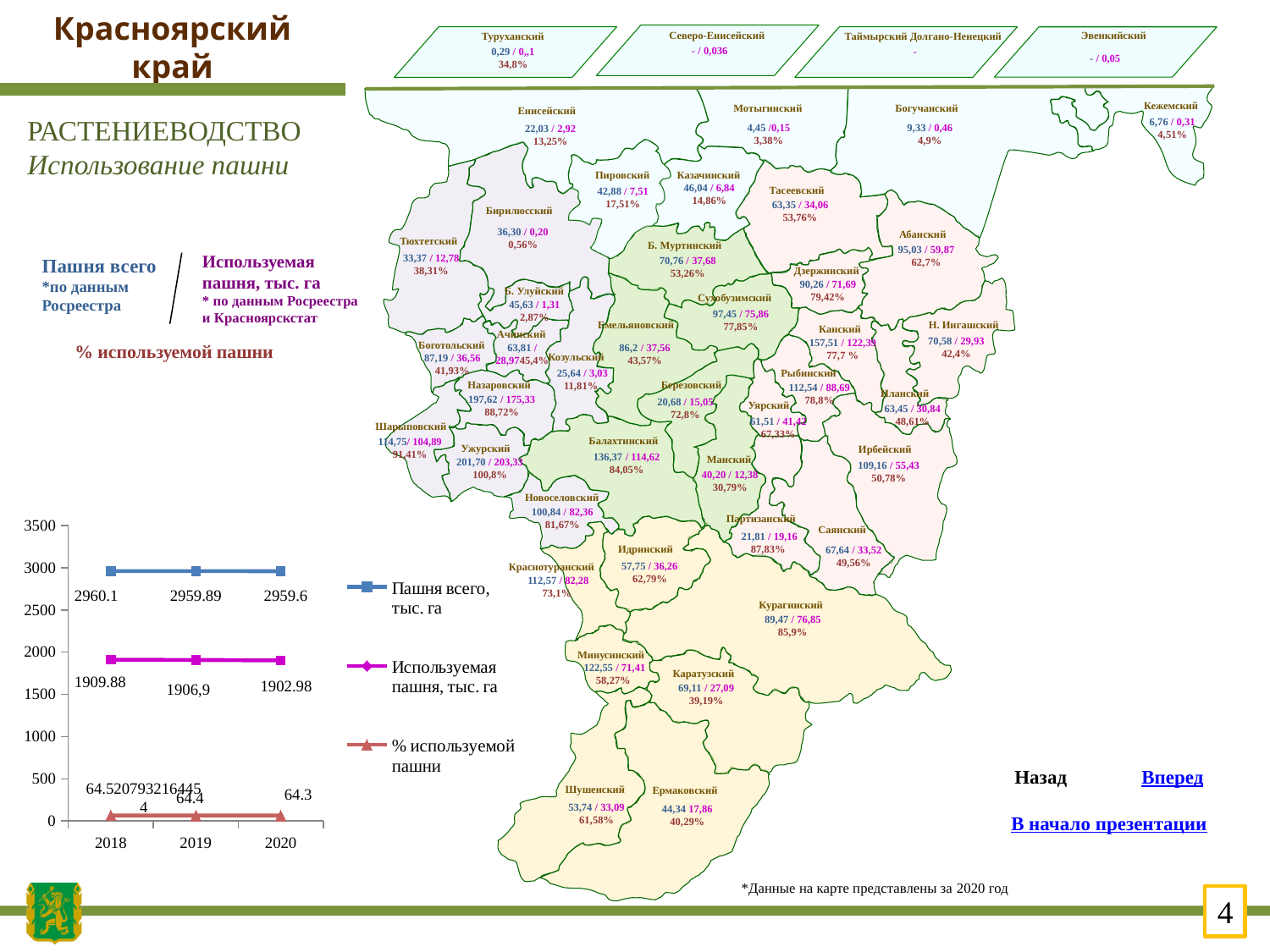
What is the value of 'Пашня всего, тыс. га' for 2020? 2959.6 What is the value of '% используемой пашни' for 2020? 64.3 Which series has the highest values in the line chart? Пашня всего, тыс. га Which is larger: 'Пашня всего, тыс. га' in 2019 or 'Используемая пашня, тыс. га' in 2019? Пашня всего, тыс. га What is the value of 'Используемая пашня, тыс. га' for 2019? 1906,9 What is the value of 'Используемая пашня, тыс. га' for 2020? 1902.98 How many years are shown on the x axis of the line chart? 3 Is the value of 'Используемая пашня, тыс. га' for 2018 greater or less than 2000? less How many series does the legend of the line chart list? 3 What type of chart is shown at the bottom left of the slide? line chart What is the value of 'Пашня всего, тыс. га' for 2018? 2960.1 Does 'Используемая пашня, тыс. га' rise or fall from 2018 to 2020? fall